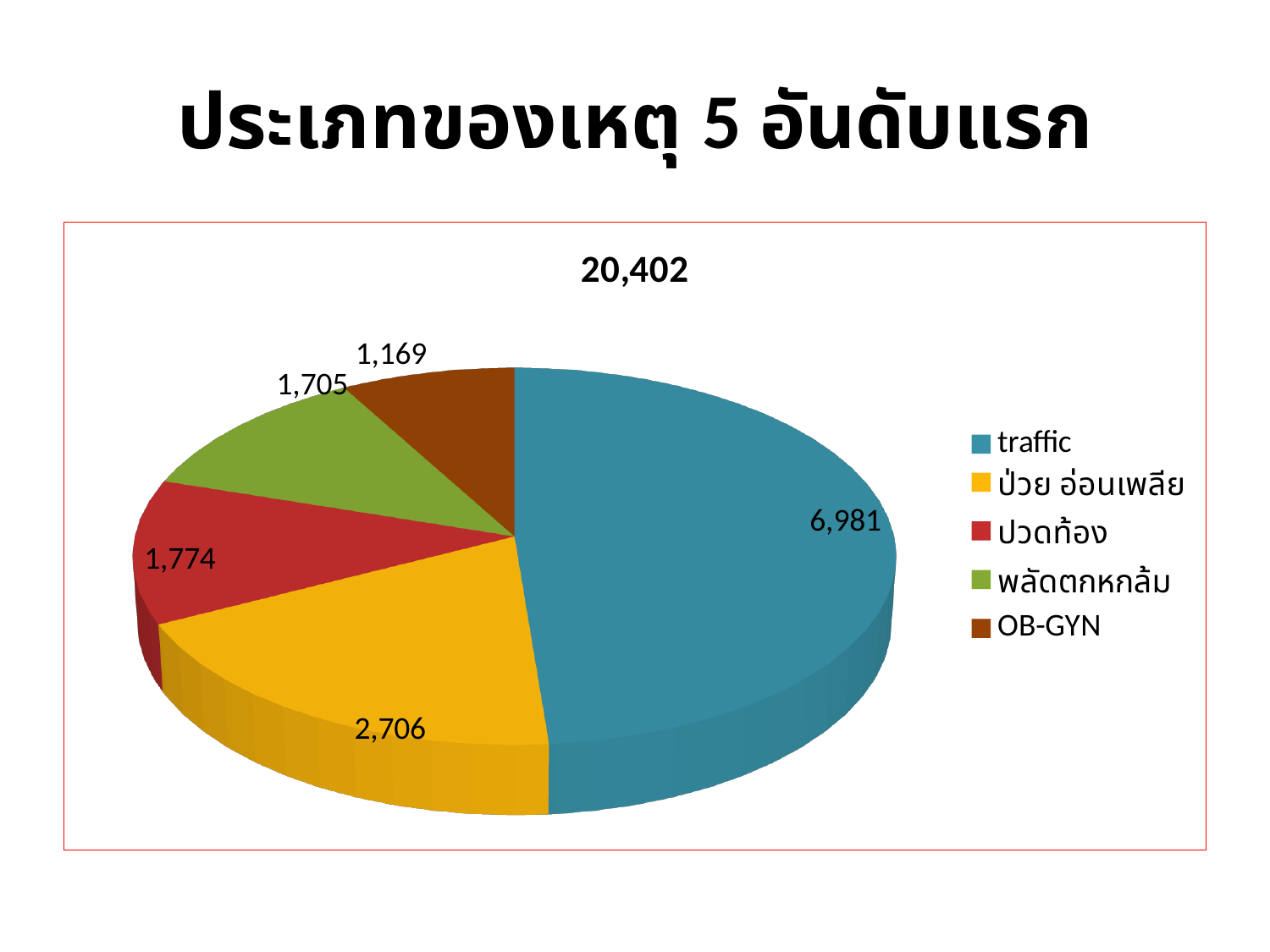
Which is larger, the value for ปวดท้อง or the value for พลัดตกหกล้ม? ปวดท้อง What is the value of the OB-GYN slice? 1,169 Which category has the smallest slice of the pie? OB-GYN Which category has the largest slice of the pie? traffic What is the value of the ป่วย อ่อนเพลีย slice? 2,706 What is the difference between the traffic value and the ป่วย อ่อนเพลีย value? 4,275 What is the difference between the ปวดท้อง value and the พลัดตกหกล้ม value? 69 What is the value of the ปวดท้อง slice? 1,774 What is the title shown above the pie chart? 20,402 What is the value of the traffic slice? 6,981 What type of chart is shown on the slide? pie chart How many categories does the pie chart show? 5